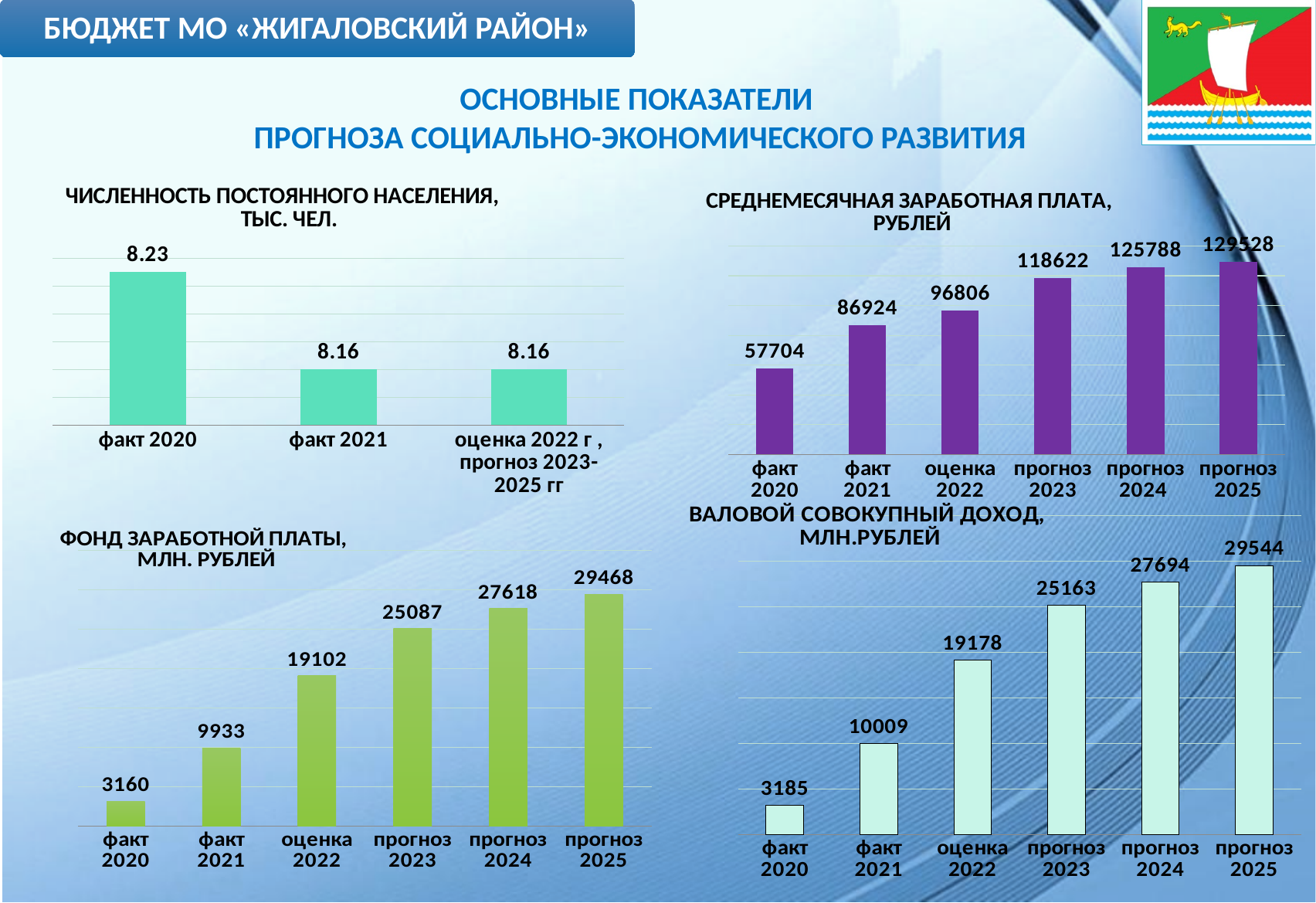
In the chart 'ФОНД ЗАРАБОТНОЙ ПЛАТЫ, МЛН. РУБЛЕЙ', which category has the highest value? прогноз 2025 In the chart 'ВАЛОВОЙ СОВОКУПНЫЙ ДОХОД, МЛН.РУБЛЕЙ', which is larger: факт 2021 or оценка 2022? оценка 2022 In the chart 'ФОНД ЗАРАБОТНОЙ ПЛАТЫ, МЛН. РУБЛЕЙ', what is the value for прогноз 2023? 25087 In the chart 'ЧИСЛЕННОСТЬ ПОСТОЯННОГО НАСЕЛЕНИЯ, ТЫС. ЧЕЛ.', how many bars are plotted? 3 In the chart 'ЧИСЛЕННОСТЬ ПОСТОЯННОГО НАСЕЛЕНИЯ, ТЫС. ЧЕЛ.', what is the difference between факт 2020 and факт 2021? 0.07 What type of chart is 'ВАЛОВОЙ СОВОКУПНЫЙ ДОХОД, МЛН.РУБЛЕЙ'? bar chart In the chart 'ЧИСЛЕННОСТЬ ПОСТОЯННОГО НАСЕЛЕНИЯ, ТЫС. ЧЕЛ.', what is the value for факт 2020? 8.23 In the chart 'СРЕДНЕМЕСЯЧНАЯ ЗАРАБОТНАЯ ПЛАТА, РУБЛЕЙ', do the values rise or fall from факт 2020 to прогноз 2025? rise In the chart 'ВАЛОВОЙ СОВОКУПНЫЙ ДОХОД, МЛН.РУБЛЕЙ', what is the value for оценка 2022? 19178 In the chart 'ФОНД ЗАРАБОТНОЙ ПЛАТЫ, МЛН. РУБЛЕЙ', what is the difference between прогноз 2025 and прогноз 2024? 1850 In the chart 'СРЕДНЕМЕСЯЧНАЯ ЗАРАБОТНАЯ ПЛАТА, РУБЛЕЙ', what is the value for факт 2021? 86924 In the chart 'СРЕДНЕМЕСЯЧНАЯ ЗАРАБОТНАЯ ПЛАТА, РУБЛЕЙ', which category has the lowest value? факт 2020